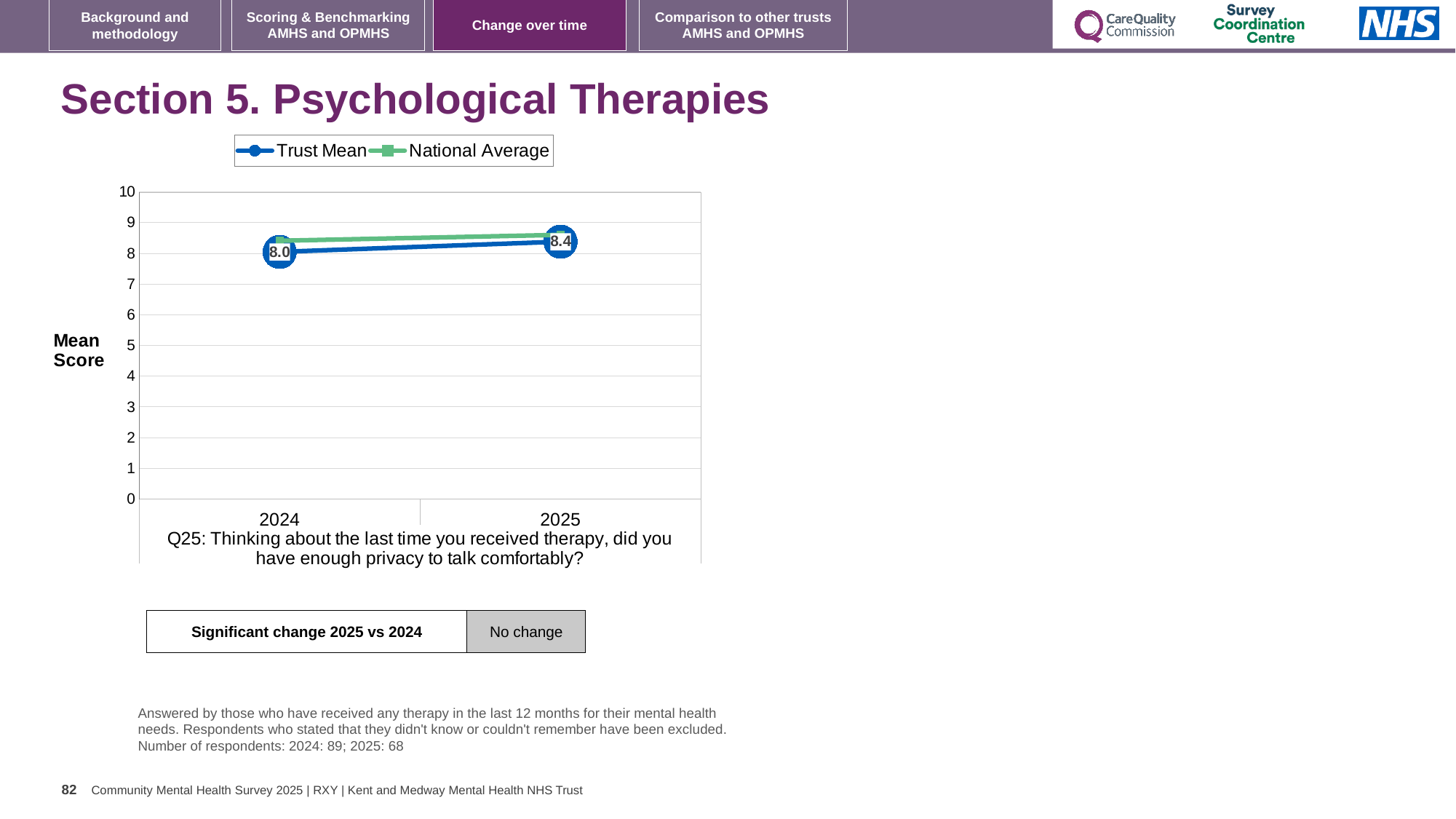
How many years are shown on the x axis of the chart? 2 By how much did the Trust Mean change from 2024 to 2025? 0.4 Does the Trust Mean rise or fall from 2024 to 2025? rise What is the Trust Mean value for 2025? 8.4 What are the two series named in the chart legend? Trust Mean and National Average What kind of chart is shown on the slide? line chart How many series does the chart legend list? 2 Is the National Average value for 2025 greater or less than 9? less Is the National Average value for 2024 greater or less than 8? greater What is the Trust Mean value for 2024? 8.0 What is the label on the y axis of the chart? Mean Score Which year has the higher Trust Mean, 2024 or 2025? 2025